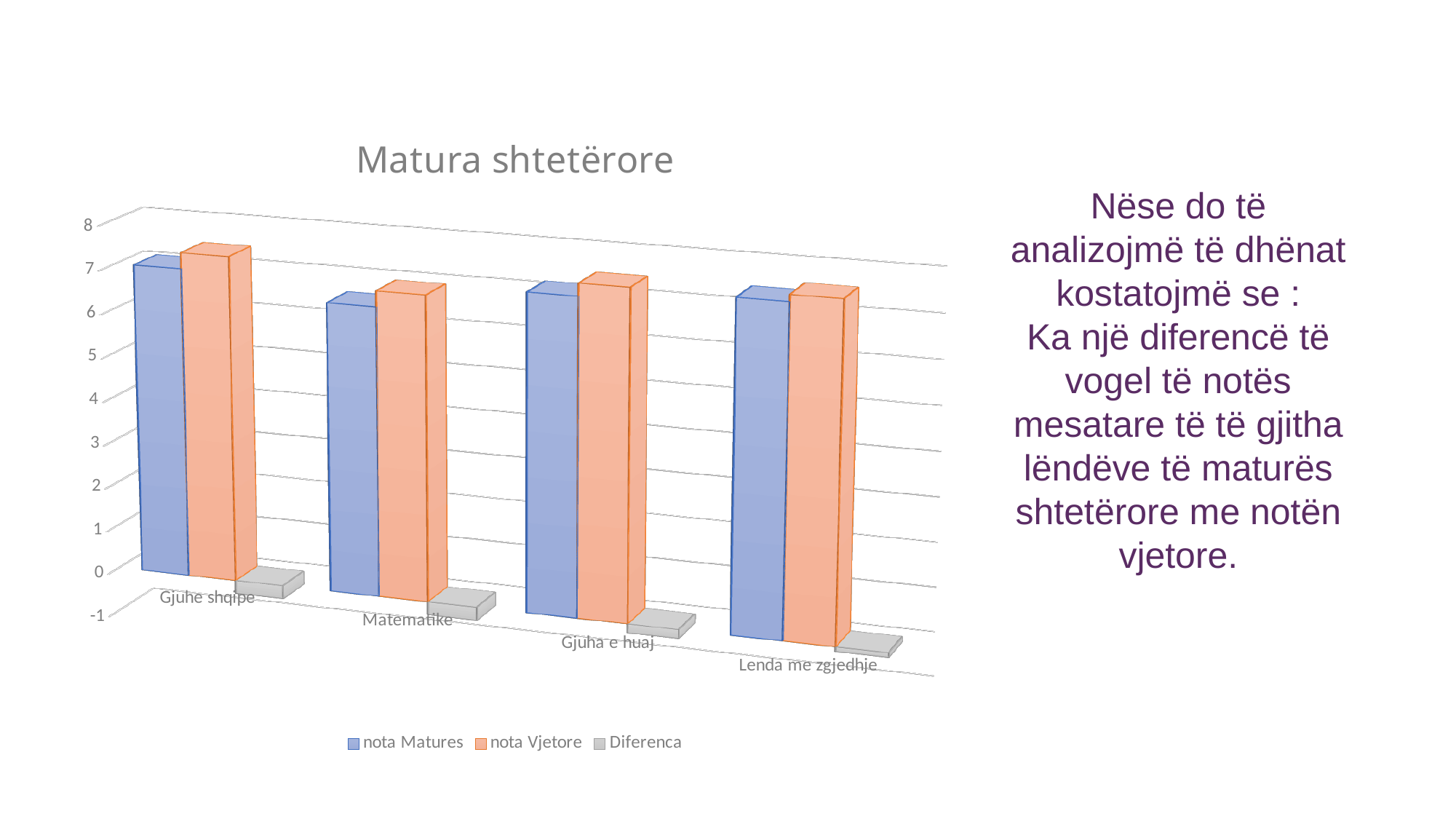
Is the value of nota Matures for Gjuhe shqipe greater or less than 6? greater What kind of chart is shown on the slide? bar chart Is the value of nota Vjetore for Gjuha e huaj greater or less than 5? greater Which is larger, nota Matures for Gjuhe shqipe or nota Matures for Matematike? Gjuhe shqipe How many categories are shown on the x axis of the chart? 4 Is the value of nota Matures for Matematike greater or less than 7? less How many series does the chart's legend list? 3 Which series is shown in orange in the chart? nota Vjetore What is the title of the chart? Matura shtetërore